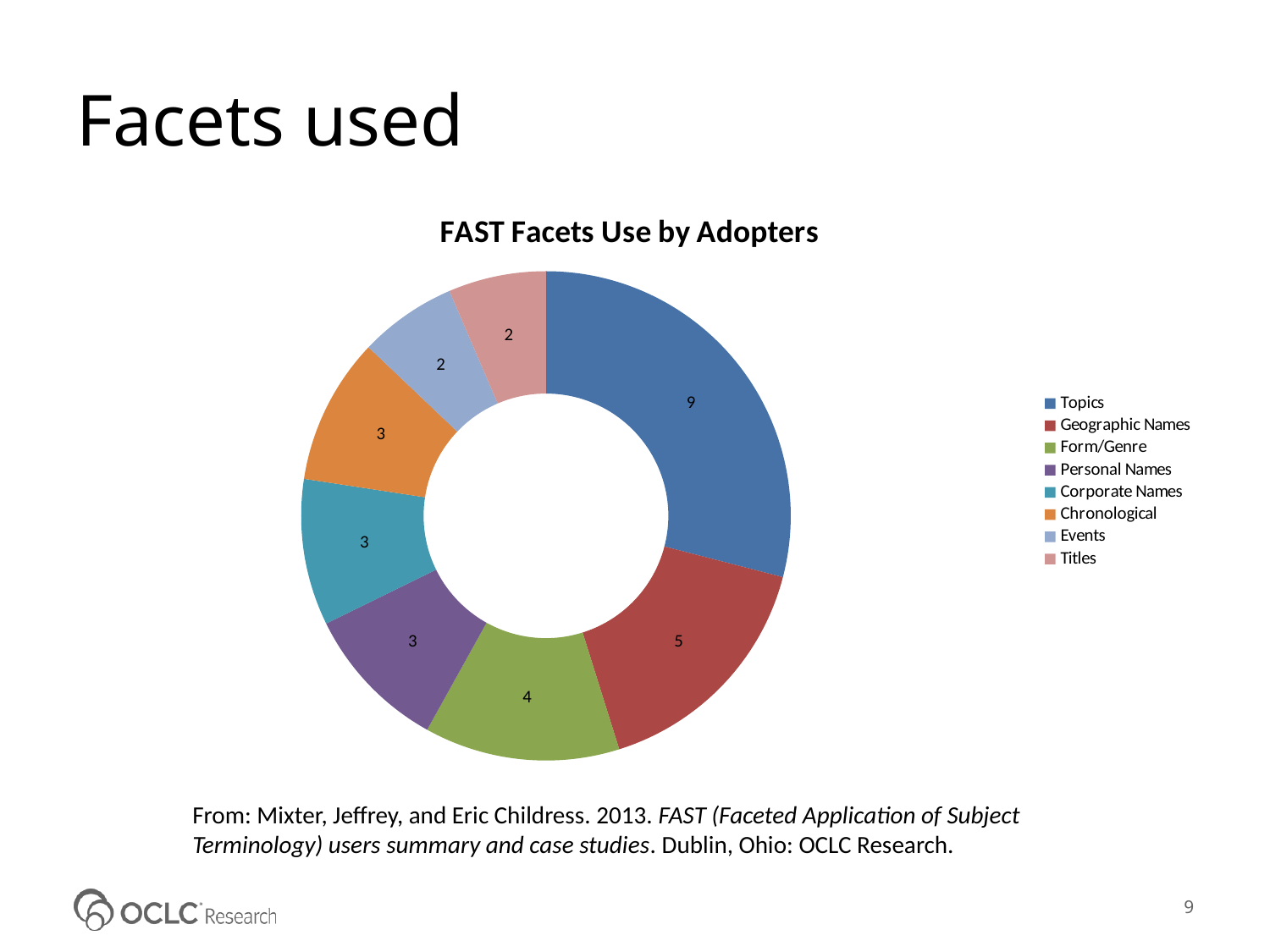
What is the value for Topics? 9 Which is larger, the value for Form/Genre or the value for Events? Form/Genre What kind of chart is shown on the slide? doughnut chart What is the title of the chart? FAST Facets Use by Adopters What is the difference between the values for Topics and Geographic Names? 4 What is the value for Geographic Names? 5 What is the total of all the values shown in the chart? 31 What is the value for Chronological? 3 Which facet has the highest value? Topics What is the value for Titles? 2 How many facets are listed in the legend? 8 What is the value for Form/Genre? 4